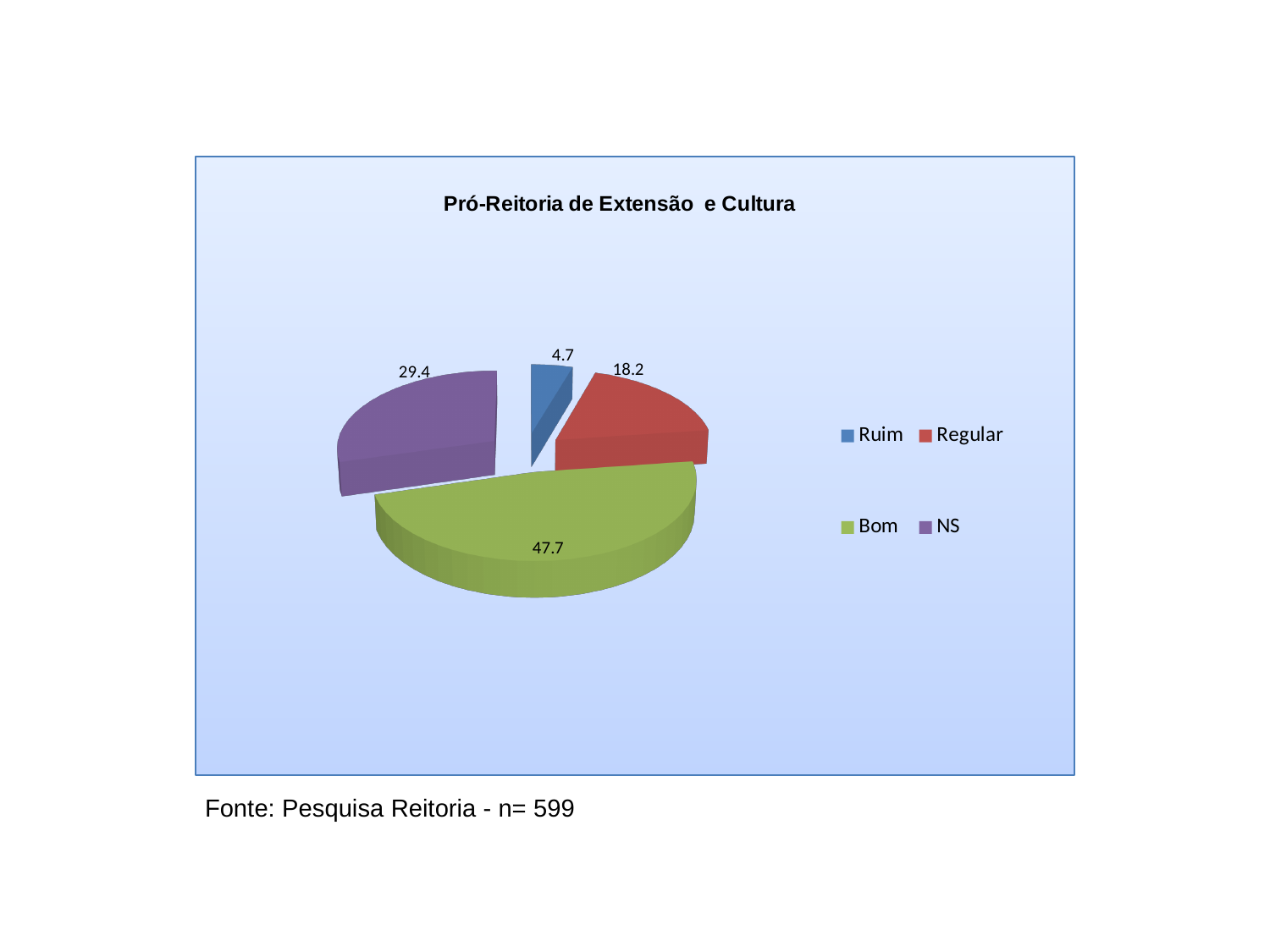
Which category has the largest slice? Bom What kind of chart is shown on the slide? Pie chart What is the value for NS? 29.4 How many slices does the pie chart have? 4 What is the difference between the values for Regular and Ruim? 13.5 Which category has the smallest slice? Ruim What is the difference between the values for Bom and NS? 18.3 What is the value for Bom? 47.7 Which is larger, the value for NS or the value for Regular? NS What is the value for Ruim? 4.7 What is the value for Regular? 18.2 What is the title of the chart? Pró-Reitoria de Extensão e Cultura